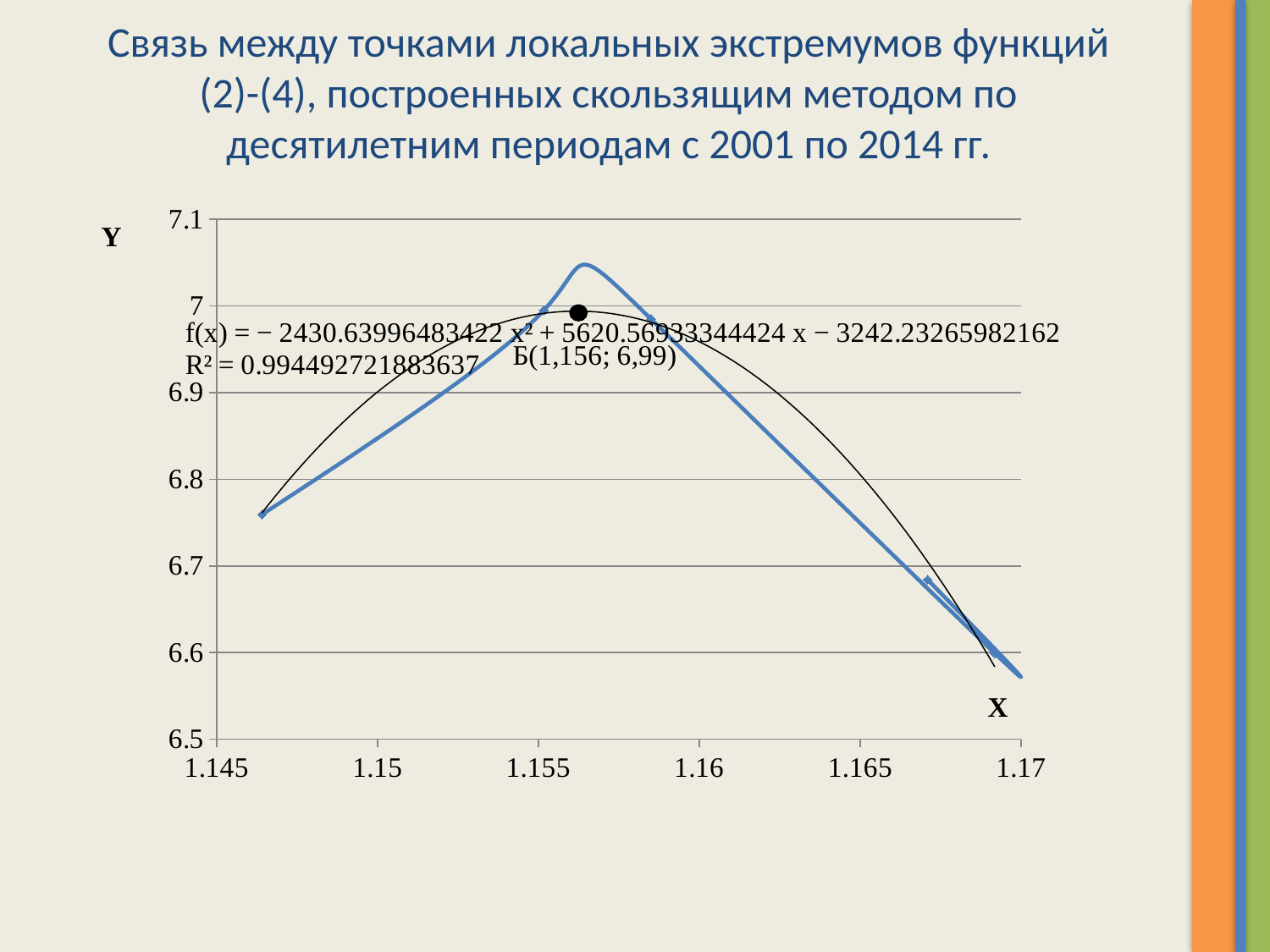
Is the value of the blue curve at its left end (near x = 1.1465) greater or less than 6.7? greater What are the coordinates of the labelled point Б on the chart? (1,156; 6,99) Does the blue curve rise or fall as x increases from 1.147 to 1.155? rises What is the coefficient of x² in the fitted function f(x) shown on the chart? − 2430.63996483422 What is the highest value shown on the Y axis of the chart? 7.1 What is the constant term of the fitted function f(x) shown on the chart? − 3242.23265982162 Does the blue curve rise or fall as x increases from 1.16 to 1.17? falls What kind of chart is shown on the slide? line chart Is the value of the blue curve at its right end (near x = 1.17) greater or less than 6.6? less What is the R² value shown for the fitted function on the chart? 0.994492721883637 What is the lowest value shown on the X axis of the chart? 1.145